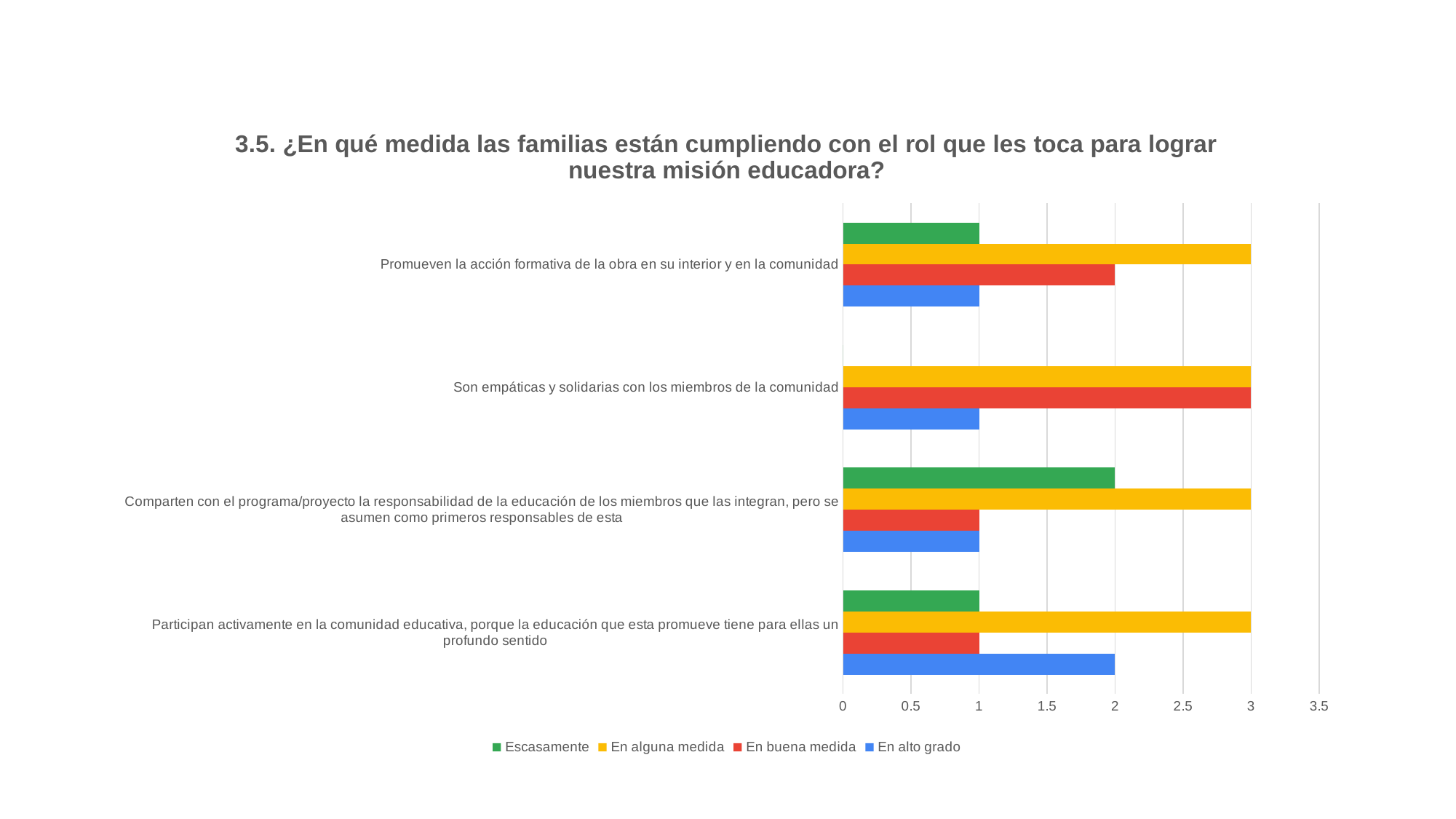
For 'Son empáticas y solidarias con los miembros de la comunidad', which is larger: 'En buena medida' or 'En alto grado'? En buena medida What is the value of 'En alguna medida' for 'Son empáticas y solidarias con los miembros de la comunidad'? 3 How many series does the legend list? 4 What type of chart is shown on the slide? Bar chart Which series has the highest value for 'Promueven la acción formativa de la obra en su interior y en la comunidad'? En alguna medida What is the value of 'En buena medida' for 'Promueven la acción formativa de la obra en su interior y en la comunidad'? 2 How many categories are shown on the chart? 4 What is the value of 'En alto grado' for 'Participan activamente en la comunidad educativa, porque la educación que esta promueve tiene para ellas un profundo sentido'? 2 What is the difference between 'En alguna medida' and 'En buena medida' for 'Participan activamente en la comunidad educativa, porque la educación que esta promueve tiene para ellas un profundo sentido'? 2 Is the value of 'En buena medida' for 'Son empáticas y solidarias con los miembros de la comunidad' greater or less than 2? greater What is the value of 'Escasamente' for 'Comparten con el programa/proyecto la responsabilidad de la educación de los miembros que las integran, pero se asumen como primeros responsables de esta'? 2 What colour represents the 'En alto grado' series in the legend? Blue